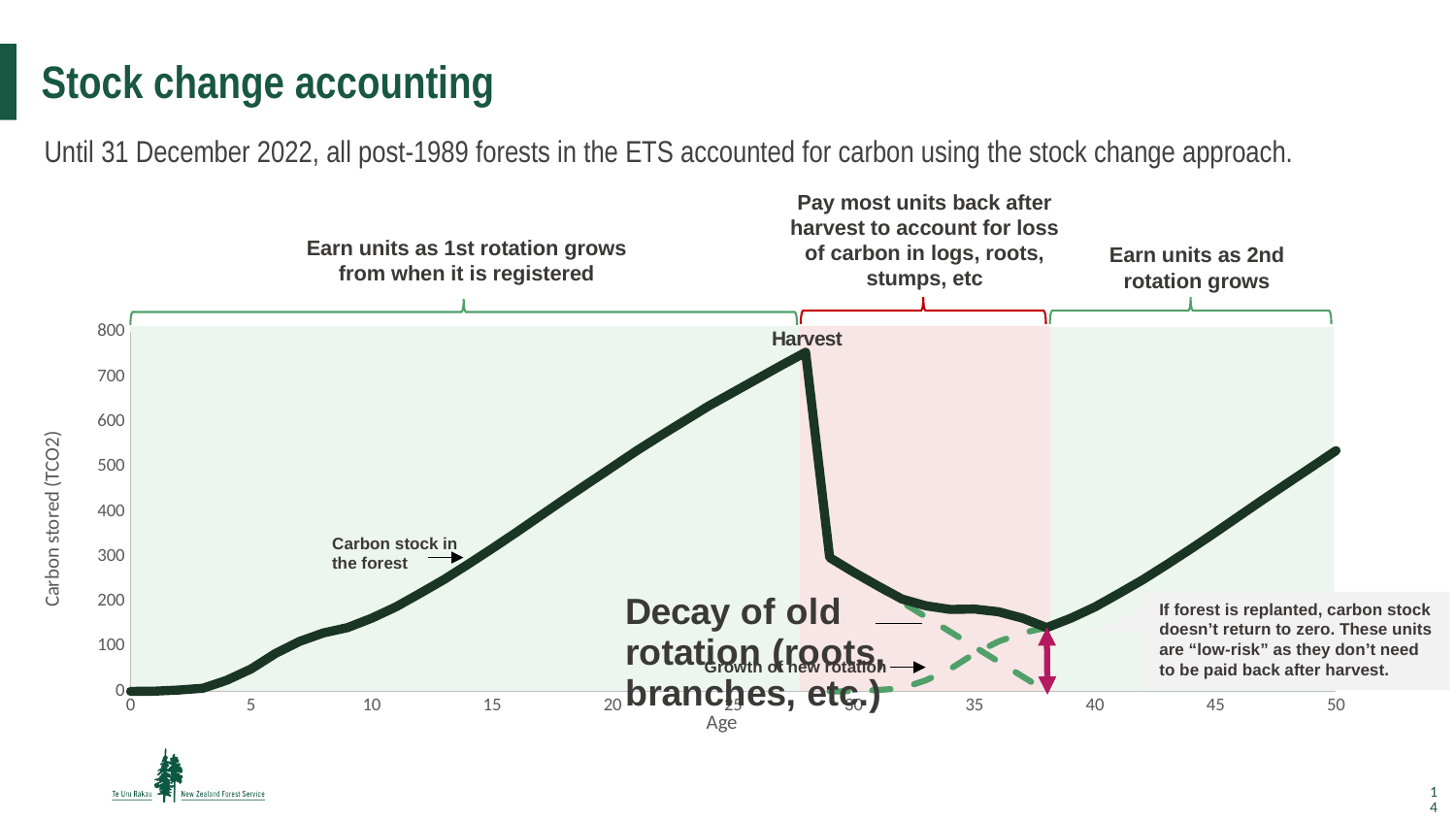
Is the carbon stored at age 35 greater or less than 300? less Is the carbon stored at age 10 greater or less than 200? less Which is larger, the carbon stored at age 25 or at age 35? Age 25 What is the label of the x axis of the chart? Age What kind of chart is shown on the slide? Line chart What is the highest value shown on the y axis of the chart? 800 Does the carbon stored rise or fall as age increases from 0 up to the Harvest point? rise Is the carbon stored at the Harvest peak greater or less than 700? greater What is the label of the y axis of the chart? Carbon stored (TCO2) Does the carbon stored rise or fall as age increases from 40 to 50? rise At what point on the line is the carbon stock highest, according to the label on the chart? Harvest